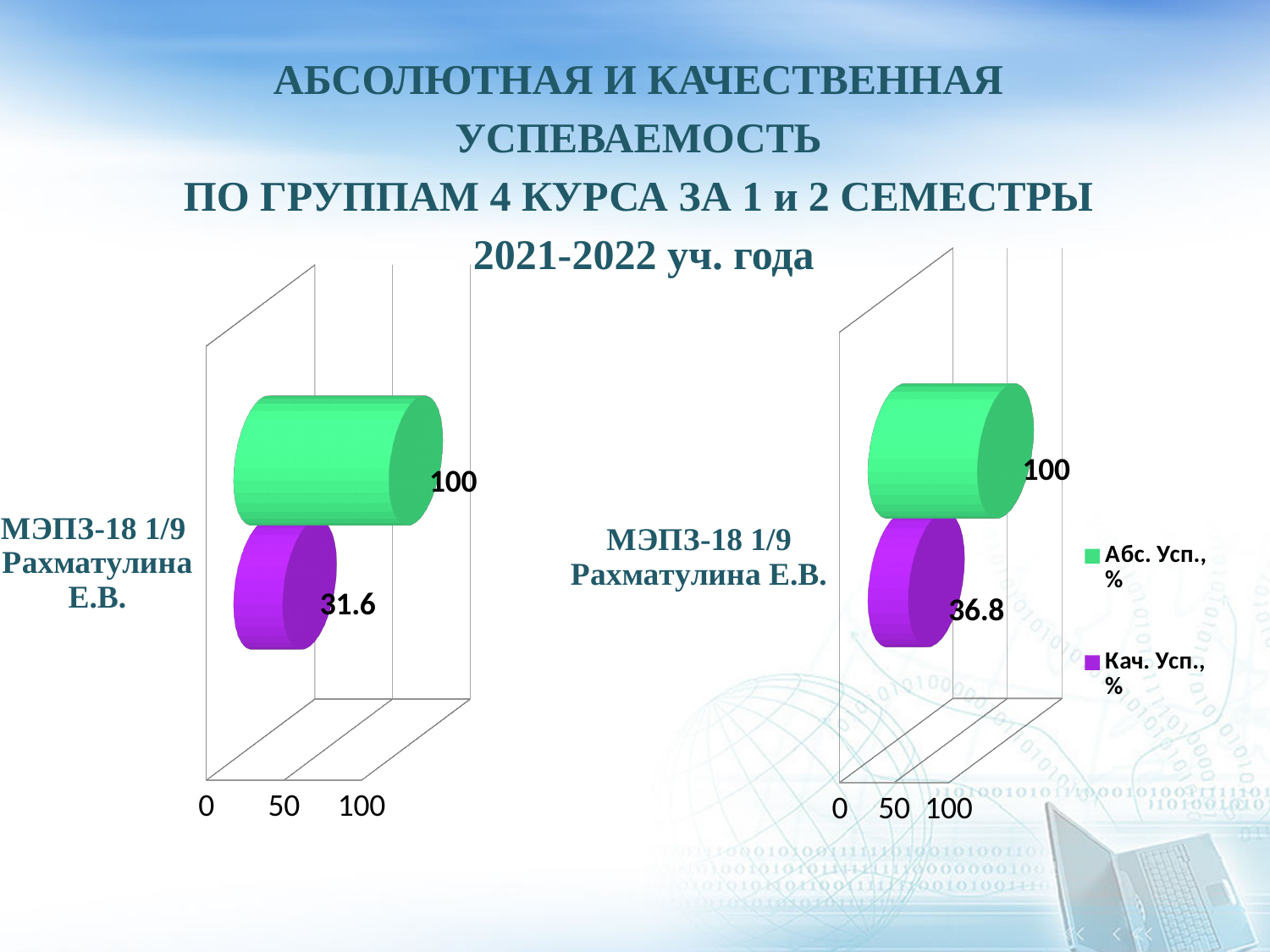
In the left chart, what is the value of the green bar (Абс. Усп., %) for МЭПЗ-18 1/9 Рахматулина Е.В.? 100 What kind of chart is the left chart? bar chart How many series does the legend on the right chart list? 2 In the right chart, what colour is the bar for the Кач. Усп., % series? purple In the right chart, what is the value of the Кач. Усп., % series for МЭПЗ-18 1/9 Рахматулина Е.В.? 36.8 In the left chart, what is the difference between the green bar value and the purple bar value? 68.4 In the right chart, what is the difference between the Абс. Усп., % value and the Кач. Усп., % value? 63.2 In the right chart, what is the value of the Абс. Усп., % series for МЭПЗ-18 1/9 Рахматулина Е.В.? 100 How many categories are shown on the x axis of the right chart? 1 In the right chart, which series has the larger value: Абс. Усп., % or Кач. Усп., %? Абс. Усп., % In the left chart, what is the value of the purple bar (Кач. Усп., %) for МЭПЗ-18 1/9 Рахматулина Е.В.? 31.6 In the left chart, is the value of the purple bar greater or less than 50? less